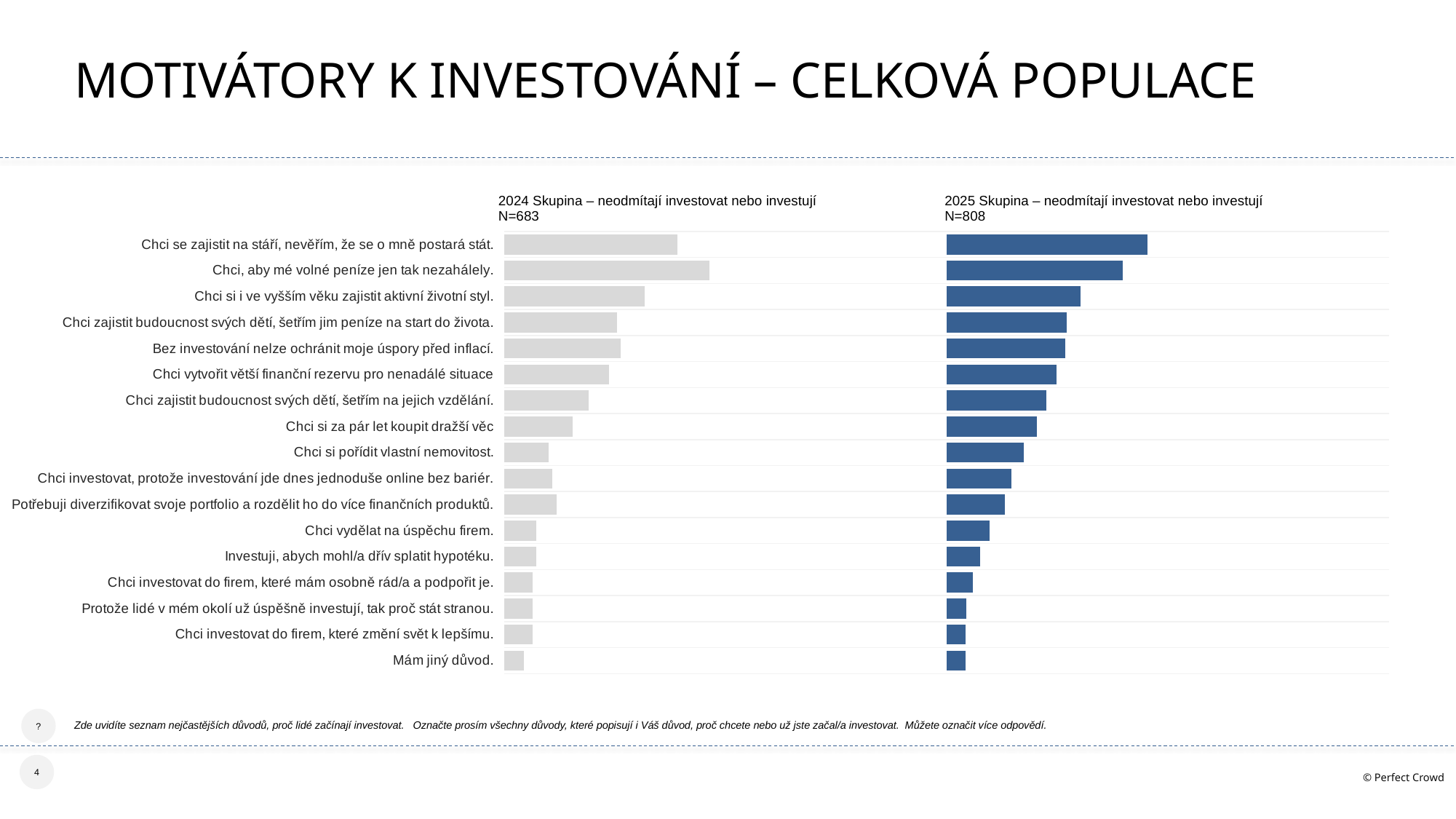
What is the sample size (N) shown for the 2024 group? N=683 In the 2025 chart (right), which bar is longer: "Chci, aby mé volné peníze jen tak nezahálely." or "Chci si i ve vyšším věku zajistit aktivní životní styl."? Chci, aby mé volné peníze jen tak nezahálely. In the 2024 chart (left), which bar is longer: "Chci se zajistit na stáří, nevěřím, že se o mně postará stát." or "Chci si i ve vyšším věku zajistit aktivní životní styl."? Chci se zajistit na stáří, nevěřím, že se o mně postará stát. What kind of chart is used on this slide to show the investment motivators? Bar chart In the 2025 chart (right), do the bars get longer or shorter going down the list of motivators? Shorter How many motivator categories are listed on the slide? 17 What is the sample size (N) shown for the 2025 group? N=808 In the 2025 chart (right), which bar is longer: "Chci vytvořit větší finanční rezervu pro nenadálé situace" or "Chci si za pár let koupit dražší věc"? Chci vytvořit větší finanční rezervu pro nenadálé situace In the 2024 chart (left), which motivator has the longest bar? Chci, aby mé volné peníze jen tak nezahálely. In the 2025 chart (right), which motivator has the longest bar? Chci se zajistit na stáří, nevěřím, že se o mně postará stát.